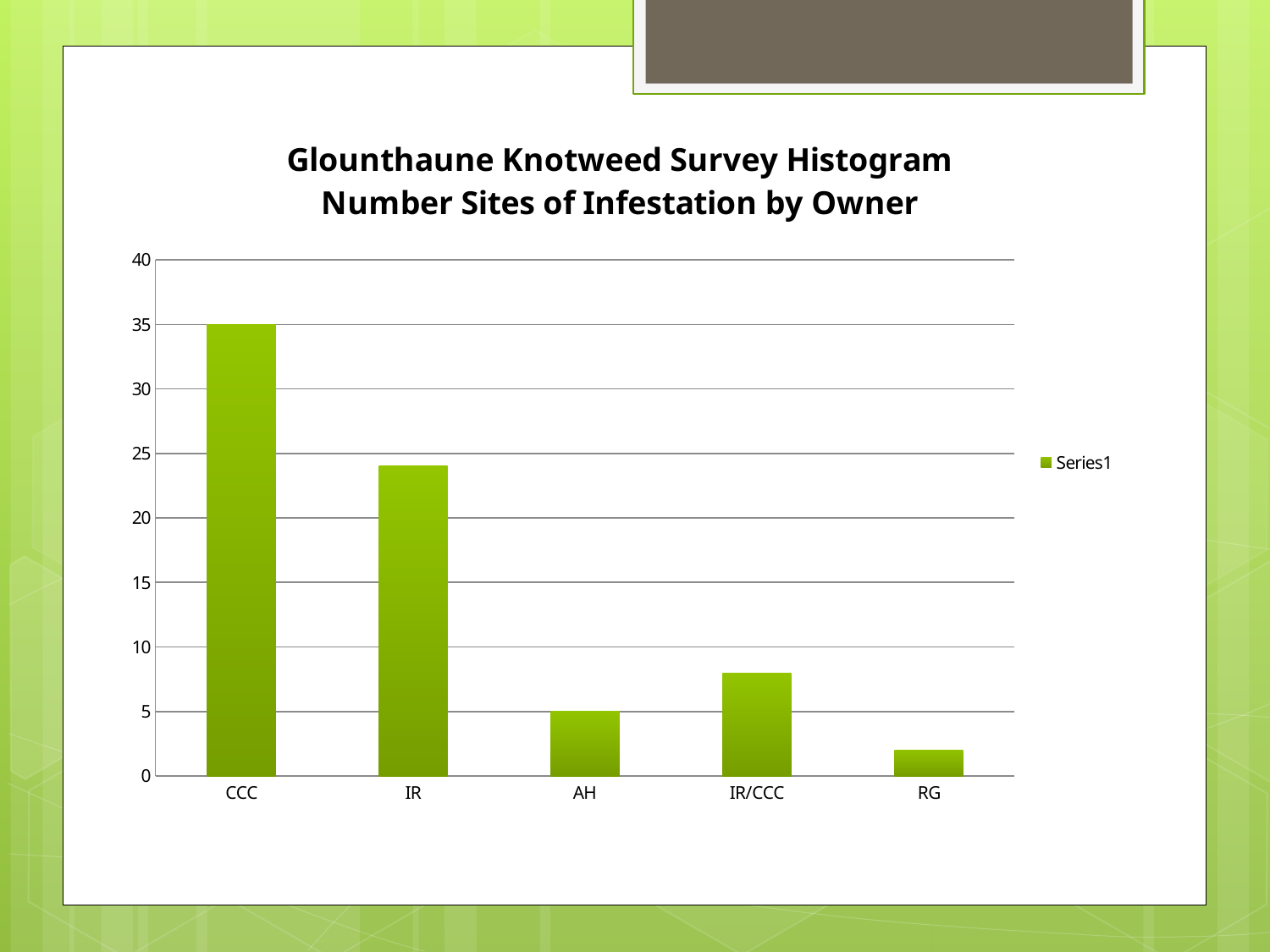
Is the value for IR greater or less than 20? greater How many series does the legend list? 1 Which owner has the lowest number of sites of infestation? RG Which has more sites of infestation, IR or IR/CCC? IR What type of chart is shown on the slide? bar chart Is the value for RG greater or less than 5? less Which owner has the highest number of sites of infestation? CCC What is the number of sites of infestation for CCC? 35 How many owner categories are shown on the x axis? 5 What is the number of sites of infestation for AH? 5 Is the value for IR/CCC greater or less than 10? less What is the difference between the values for CCC and AH? 30